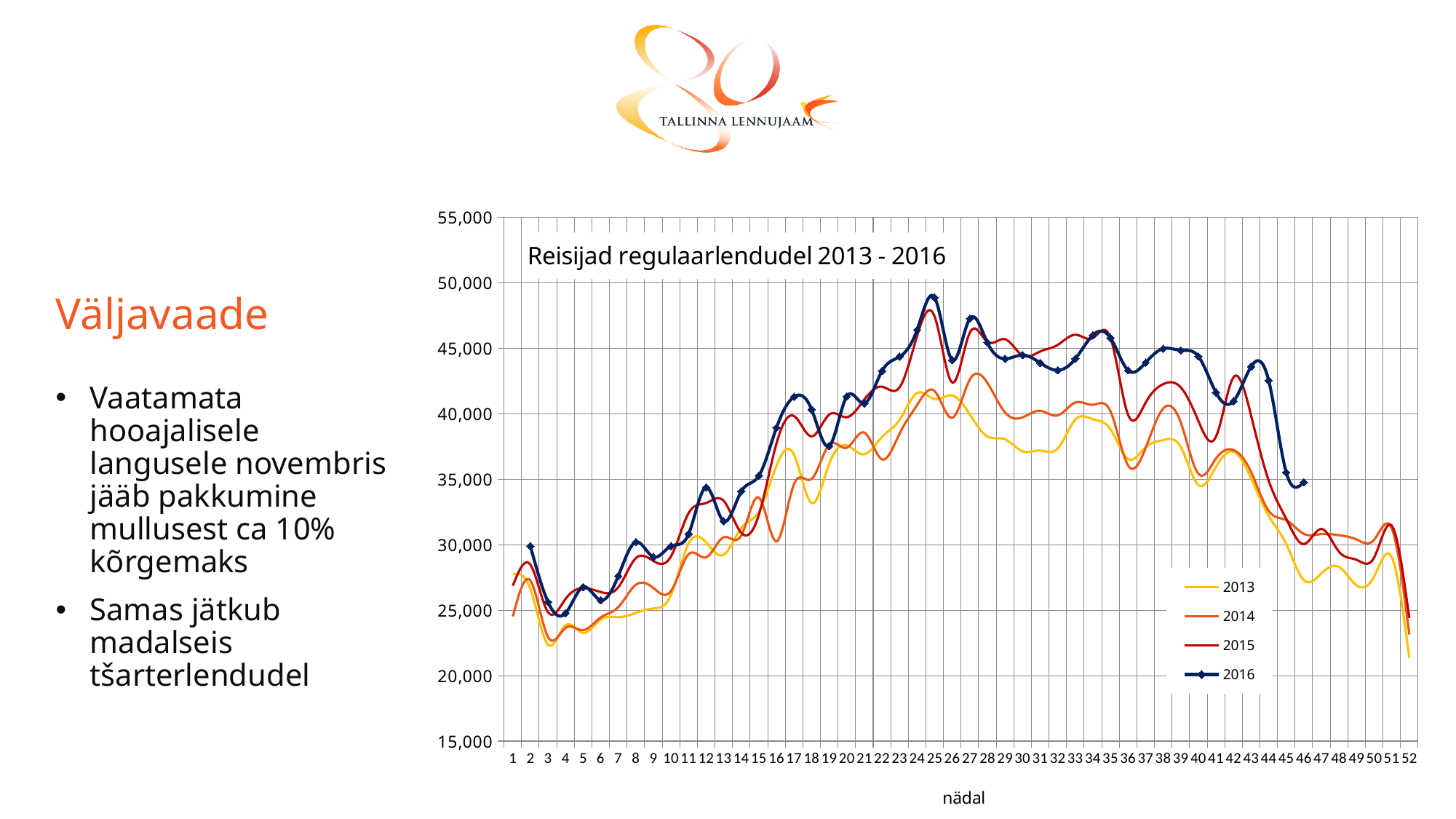
What is the title of the chart? Reisijad regulaarlendudel 2013 - 2016 What is the label of the x axis? nädal How many series does the legend list? 4 What kind of chart is shown on the slide? line chart Is the value for 2016 at week 25 greater or less than 45,000? greater At week 46, which series has the higher value, 2016 or 2014? 2016 At week 25, which series has the higher value, 2016 or 2013? 2016 Is the value for 2016 at week 46 greater or less than 40,000? less In which week does the 2016 series reach its highest value? 25 Is the value for 2013 at week 25 greater or less than 40,000? greater How many weeks are shown on the x axis? 52